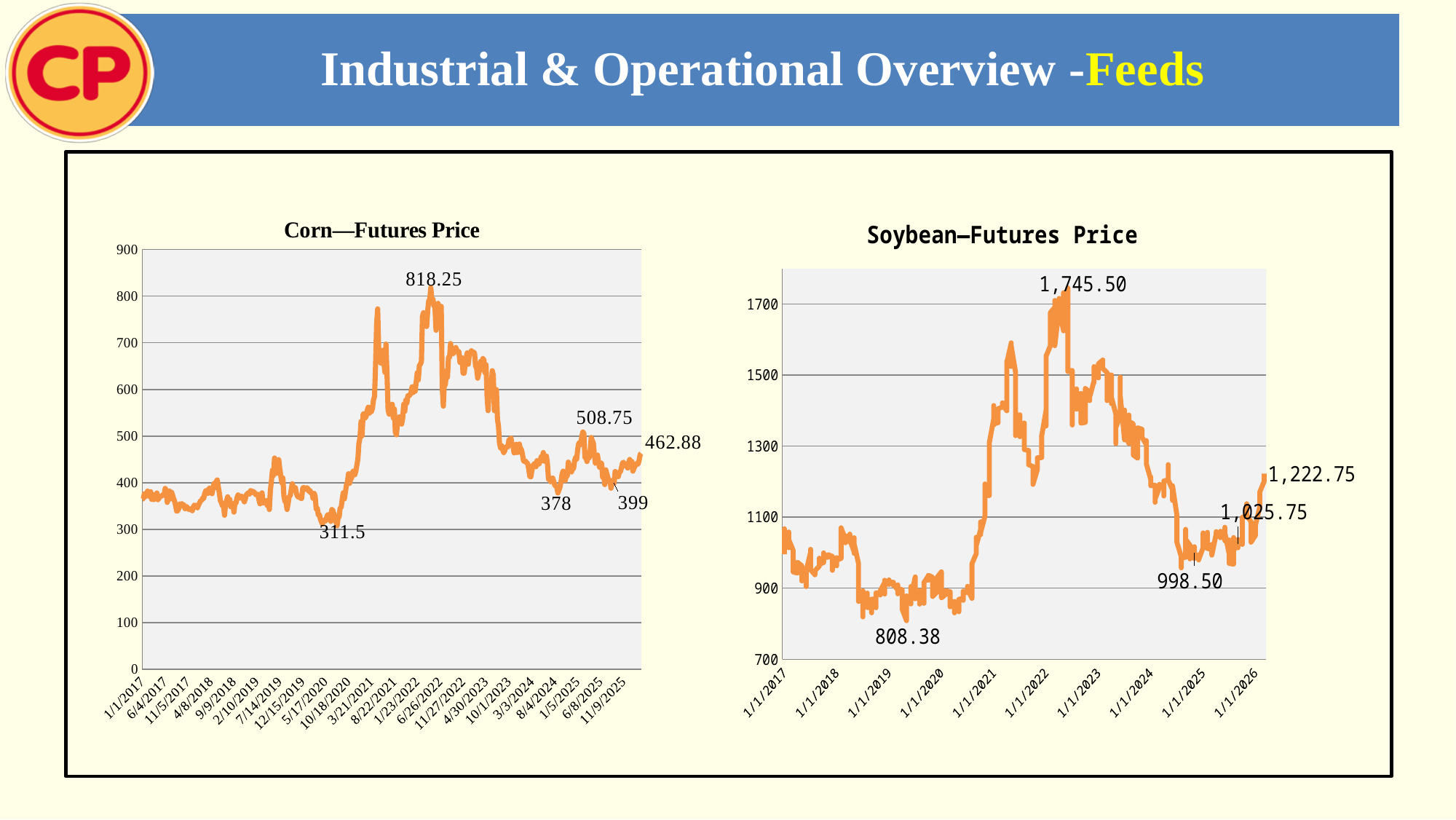
On the Soybean—Futures Price chart, what is the lowest labelled value? 808.38 On the Corn—Futures Price chart, what is the difference between the peak value 818.25 and the low value 311.5? 506.75 On the Soybean—Futures Price chart, what is the highest labelled value? 1,745.50 On the Corn—Futures Price chart, what is the last labelled value at the right end of the line? 462.88 On the Corn—Futures Price chart, what is the lowest labelled value? 311.5 What is the title of the chart on the right side of the slide? Soybean—Futures Price On the Corn—Futures Price chart, what is the highest labelled value? 818.25 On the Soybean—Futures Price chart, which labelled value is larger: 998.50 or 1,025.75? 1,025.75 What kind of chart is the Corn—Futures Price chart? line chart On the Soybean—Futures Price chart, what is the last labelled value at the right end of the line? 1,222.75 On the Soybean—Futures Price chart, what is the difference between the peak value 1,745.50 and the low value 808.38? 937.12 On the Corn—Futures Price chart, is the value at 1/1/2017 greater or less than 500? less